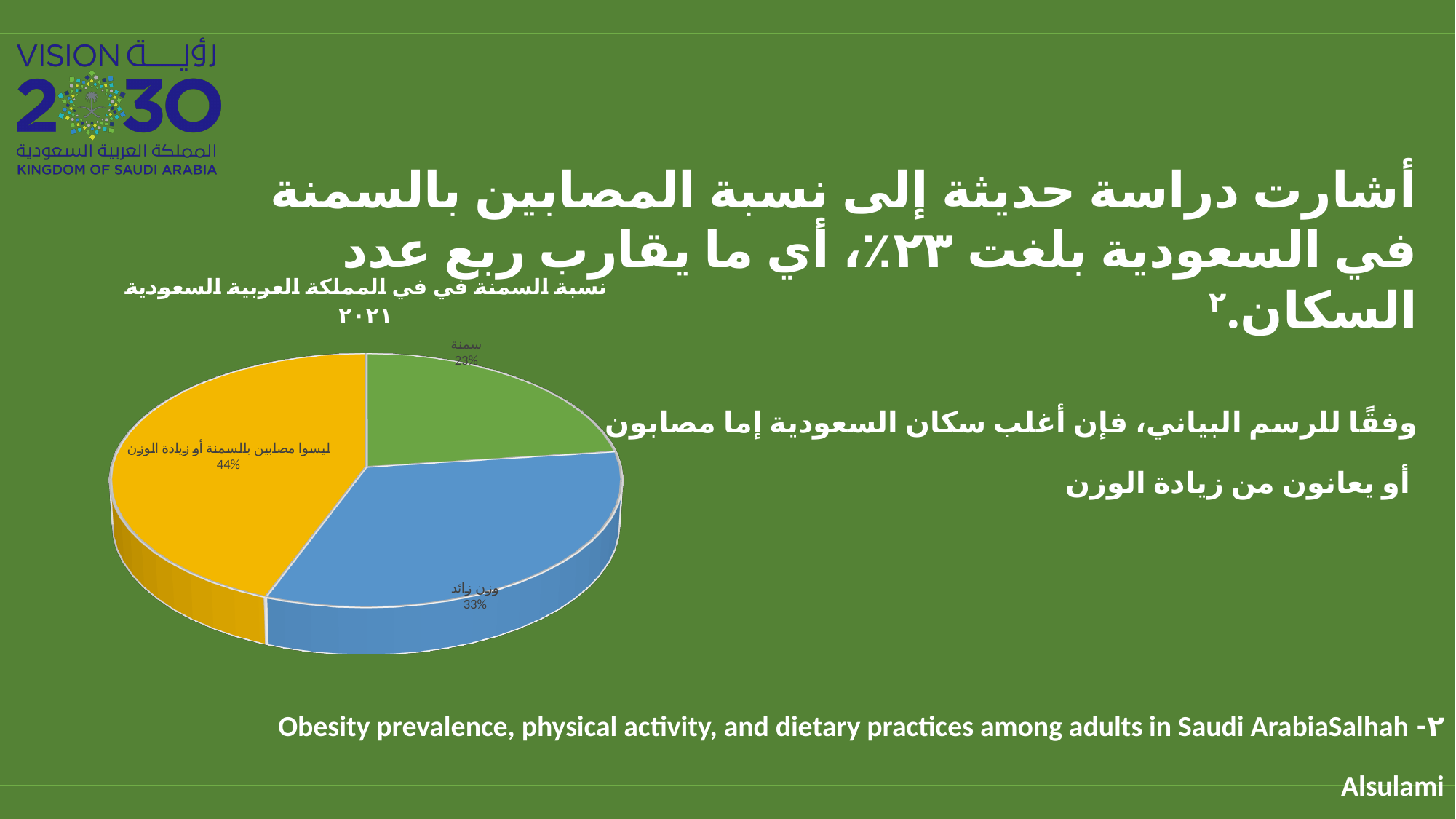
What colour is the slice labelled سمنة? green Which is larger, the slice for وزن زائد or the slice for سمنة? وزن زائد What percentage is shown for the slice labelled وزن زائد? 33% What is the difference in percentage points between the وزن زائد slice and the سمنة slice? 10 What is the difference in percentage points between the ليسوا مصابين بالسمنة أو زيادة الوزن slice and the سمنة slice? 21 Which slice of the pie chart is the largest? ليسوا مصابين بالسمنة أو زيادة الوزن What percentage is shown for the slice labelled سمنة? 23% Which slice of the pie chart is the smallest? سمنة How many slices does the pie chart have? 3 What percentage is shown for the slice labelled ليسوا مصابين بالسمنة أو زيادة الوزن? 44% What colour is the slice labelled ليسوا مصابين بالسمنة أو زيادة الوزن? yellow What kind of chart is shown on the slide? pie chart